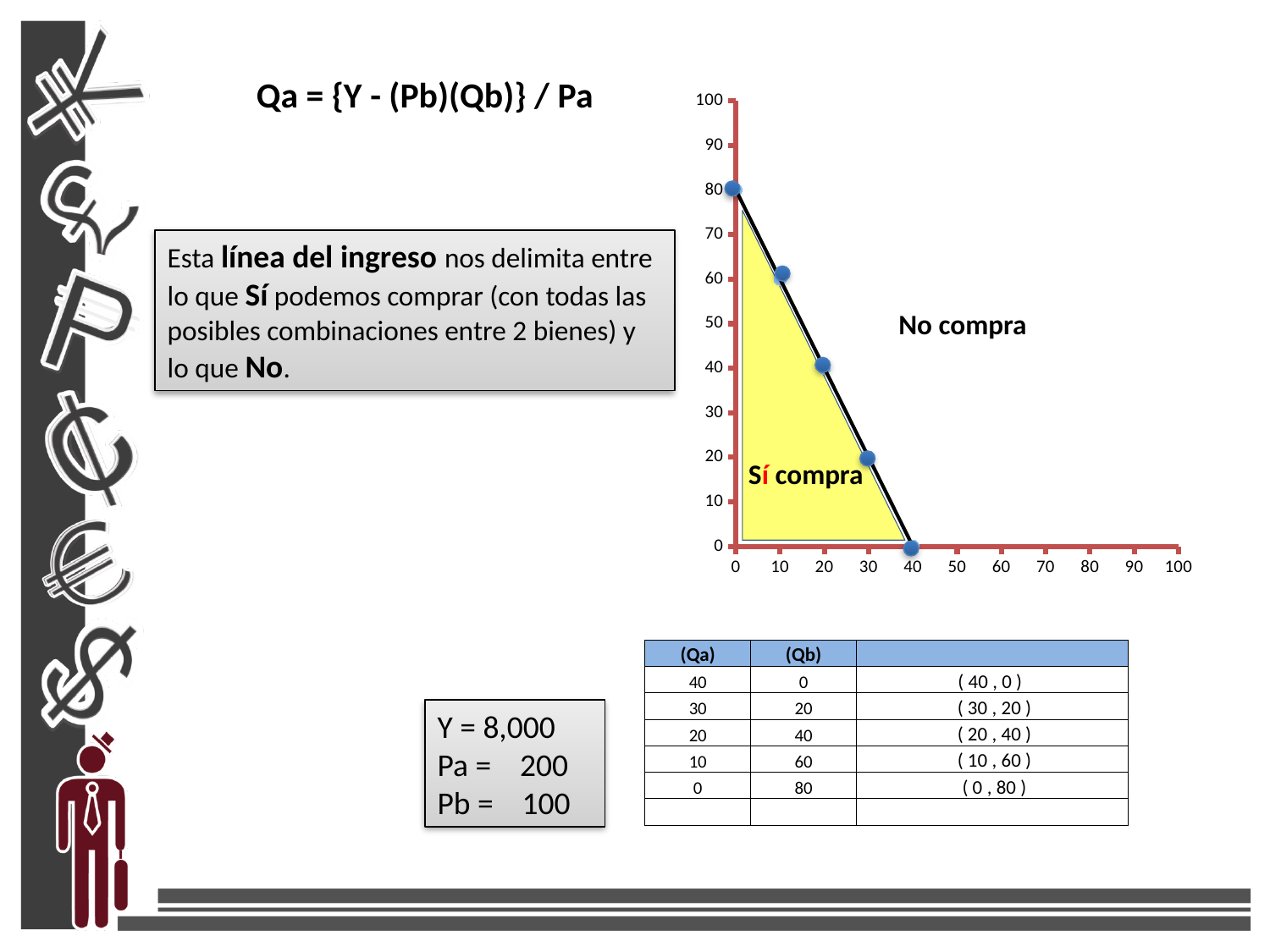
How many data points are plotted on the chart? 5 What is the y value of the plotted point at x = 0? 80 Which has the larger y value: the point at x = 20 or the point at x = 30? the point at x = 20 Is the y value of the point at x = 10 greater or less than 50? greater What is the y value of the plotted point at x = 20? 40 What label is written in the area above the line on the chart? No compra At which x value does the plotted line have its highest y value? 0 What is the difference between the y value at x = 0 and the y value at x = 10? 20 At what x value does the plotted line reach y = 0? 40 What label is written inside the yellow shaded area of the chart? Sí compra Do the plotted y values rise or fall as x increases along the x axis? fall At which x value does the plotted line have its lowest y value? 40